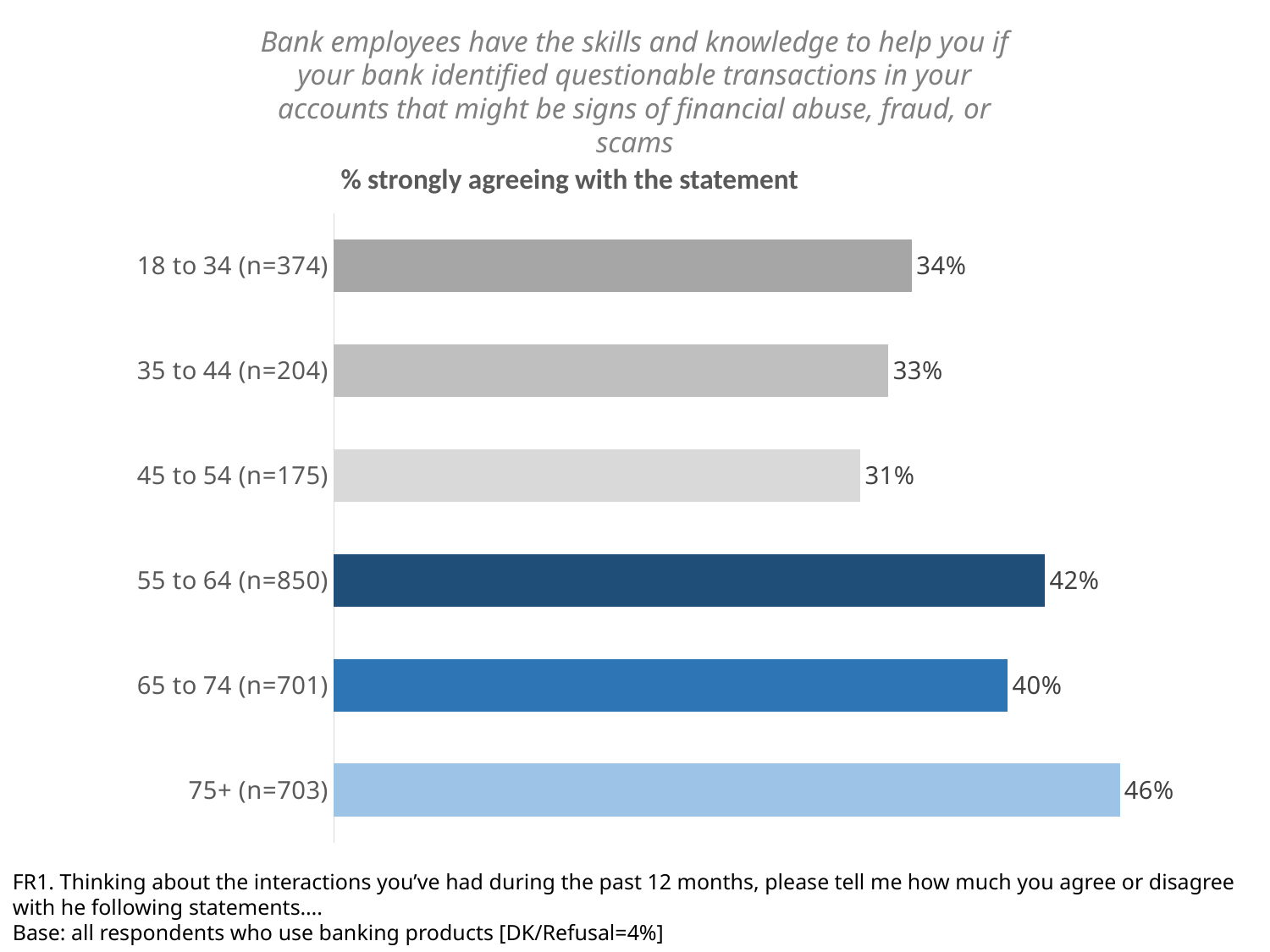
What does the subtitle say the chart measures? % strongly agreeing with the statement Which age group has the highest percentage strongly agreeing with the statement? 75+ (n=703) What kind of chart is shown on the slide? Bar chart What percentage of respondents aged 18 to 34 strongly agree with the statement? 34% What is the sample size (n) shown for the 65 to 74 age group? 701 Which is larger, the value for 35 to 44 or the value for 65 to 74? 65 to 74 What is the difference between the values for the 55 to 64 group and the 65 to 74 group? 2 percentage points What is the value shown for the 75+ age group? 46% What is the value shown for the 55 to 64 age group? 42% What is the difference between the values for the 75+ group and the 45 to 54 group? 15 percentage points Which age group has the lowest percentage strongly agreeing with the statement? 45 to 54 (n=175) How many age groups are shown in the chart? 6